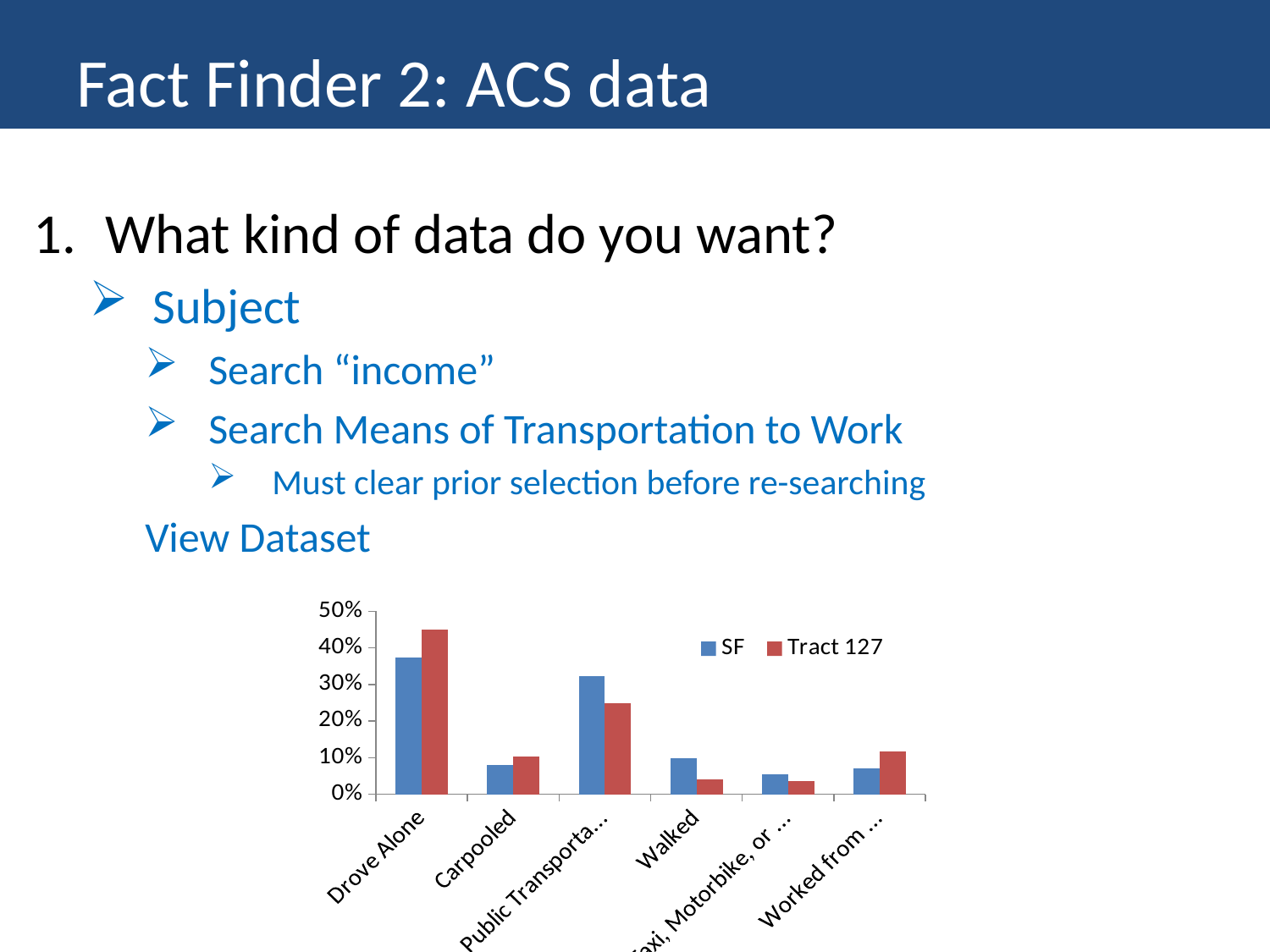
Which category has the highest value for the Tract 127 series? Drove Alone What colour represents the Tract 127 series in the chart? red What kind of chart is shown on the slide? bar chart For Walked, which series has the larger value, SF or Tract 127? SF How many series does the chart's legend list? 2 Is the SF value for Public Transportation greater or less than 30%? greater Is the Tract 127 value for Drove Alone greater or less than 40%? greater Which category has the highest value for the SF series? Drove Alone How many categories are shown along the x axis of the chart? 6 Is the SF value for Carpooled greater or less than 10%? less For Drove Alone, which series has the larger value, SF or Tract 127? Tract 127 For Public Transportation, which series has the larger value, SF or Tract 127? SF